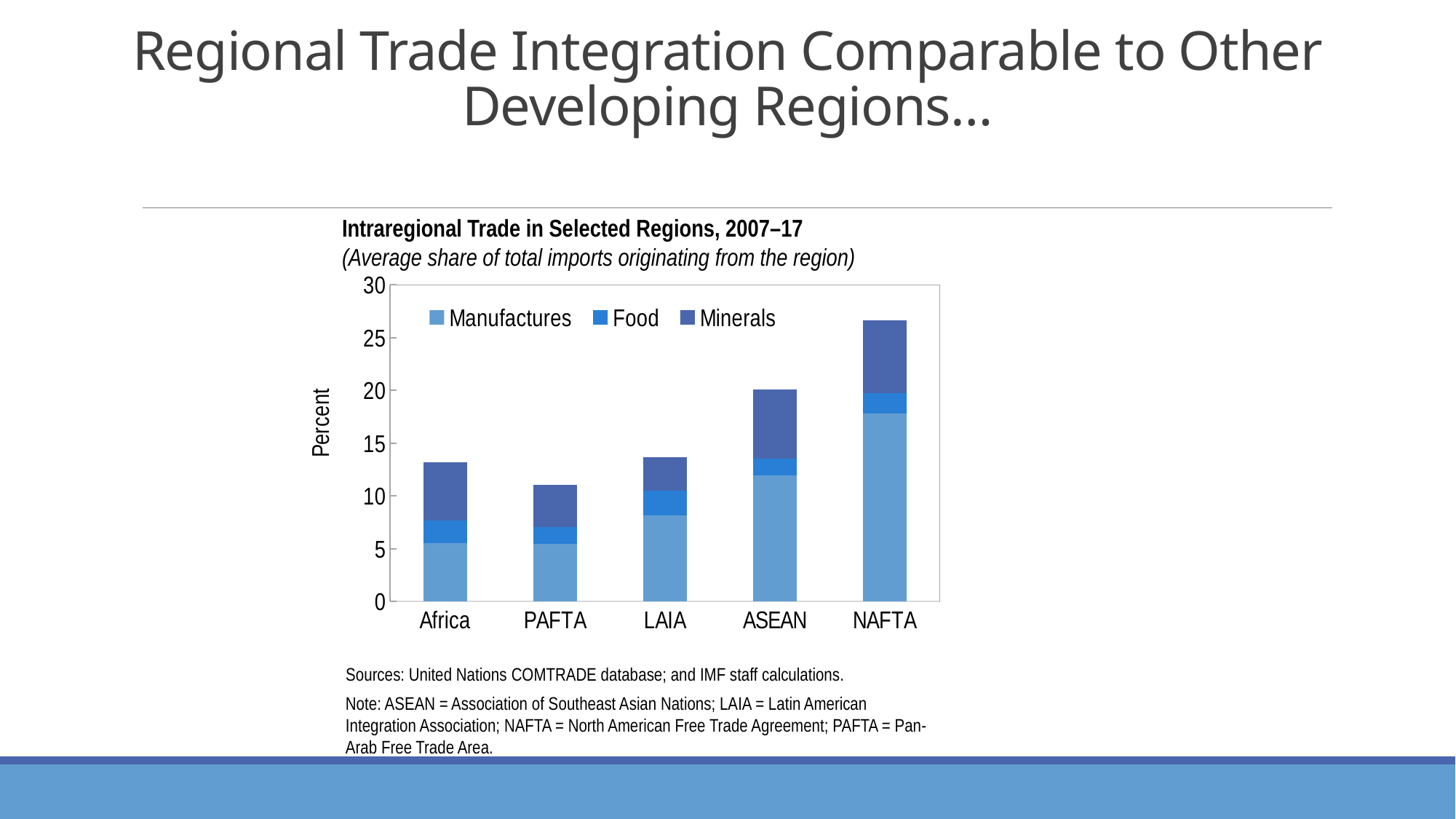
Which region has the lowest total intraregional trade share in the chart? PAFTA What is the title of the chart? Intraregional Trade in Selected Regions, 2007–17 Which has a larger total bar, ASEAN or Africa? ASEAN What is the label on the chart's vertical axis? Percent Is the total bar for PAFTA greater or less than 15? less Is the total bar for Africa greater or less than 10? greater How many series does the chart's legend list? 3 How many regions are shown on the x axis of the chart? 5 What kind of chart is shown on the slide? bar chart Is the Manufactures segment for NAFTA greater or less than 15? greater Which region has the highest total intraregional trade share in the chart? NAFTA